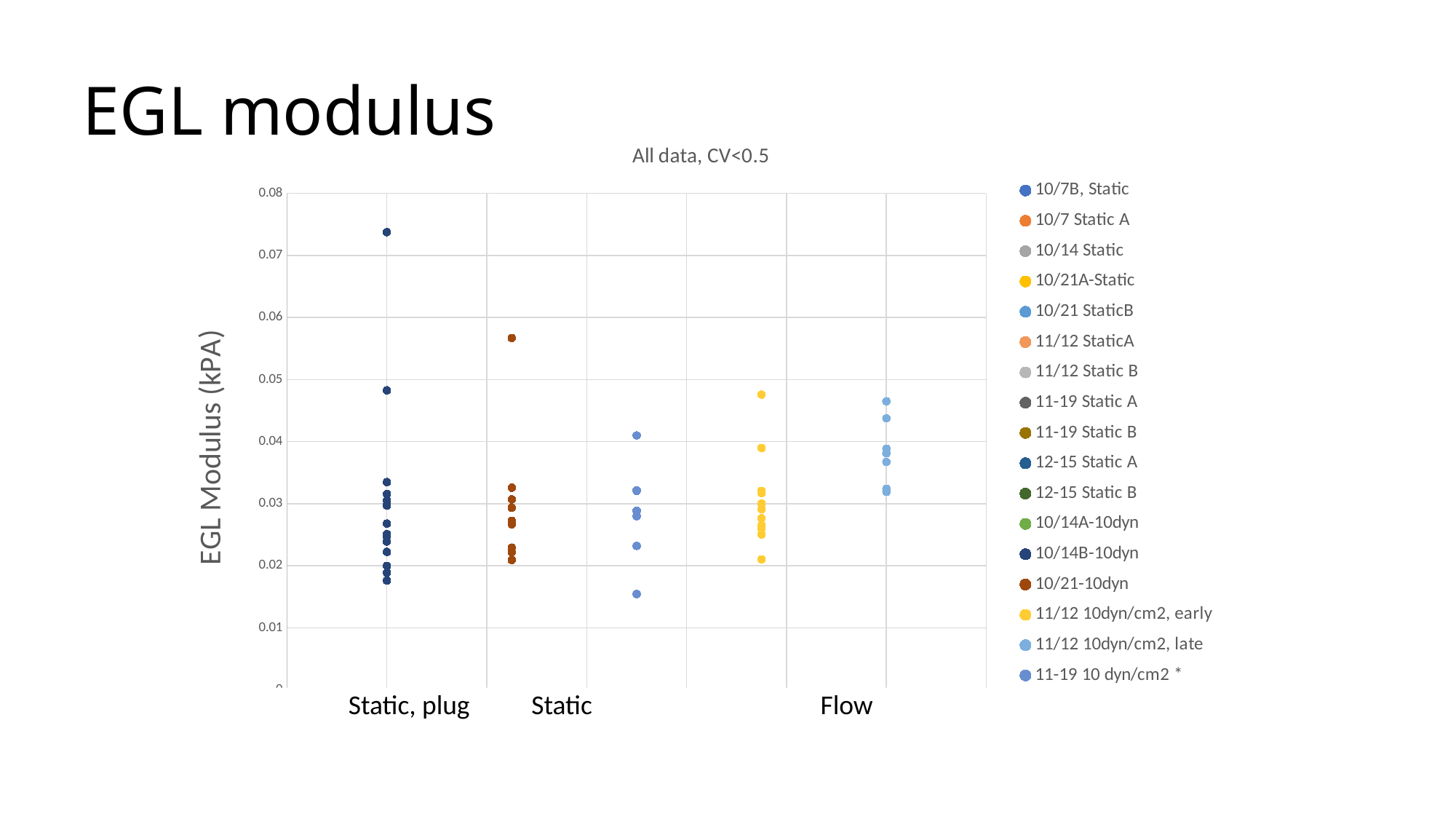
What is the label on the vertical axis? EGL Modulus (kPA) What kind of chart is shown on the slide? scatter chart Is the lowest point on the chart greater or less than 0.02? less How many group labels are shown along the x axis? 3 Is the highest point in the Static, plug group greater or less than 0.07? greater What is the highest value marked on the y axis? 0.08 Is the highest point in the Flow group greater or less than 0.05? less Which x-axis group contains the highest point on the chart? Static, plug How many series does the legend list? 17 Which has the larger maximum value: the Static, plug group or the Flow group? Static, plug What is the title of the chart? All data, CV<0.5